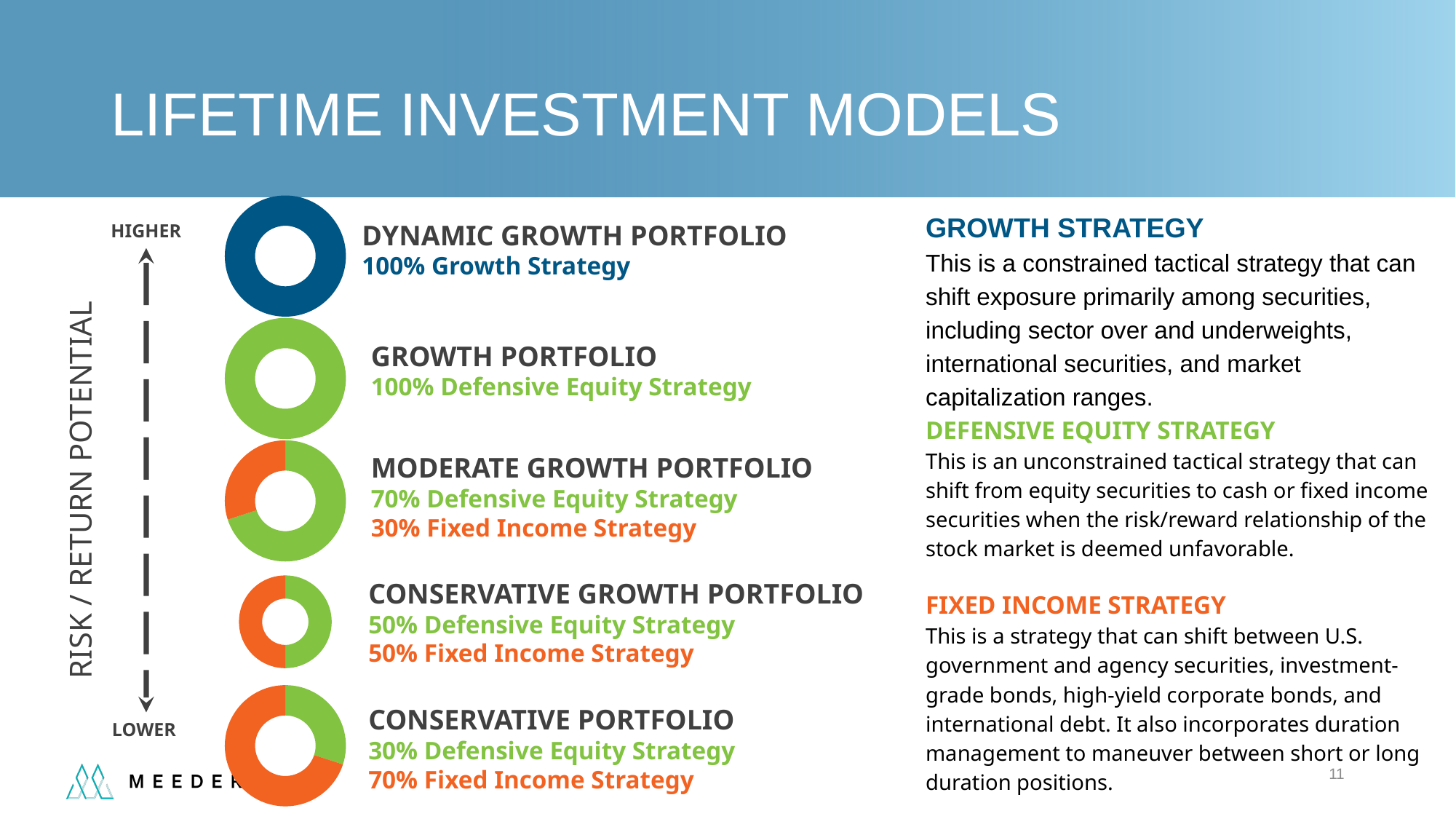
In the Conservative Portfolio chart, which slice is larger: Defensive Equity Strategy or Fixed Income Strategy? Fixed Income Strategy In the Dynamic Growth Portfolio chart, what share is allocated to the Growth Strategy? 100% Which portfolio chart has the largest Fixed Income Strategy share? Conservative Portfolio In the Moderate Growth Portfolio chart, what share is allocated to the Fixed Income Strategy? 30% In the Moderate Growth Portfolio chart, what share is allocated to the Defensive Equity Strategy? 70% What kind of chart is used to show each portfolio's allocation on the slide? Donut (pie) chart What colour represents the Fixed Income Strategy in the donut charts? Orange In the Moderate Growth Portfolio chart, what is the difference between the Defensive Equity Strategy share and the Fixed Income Strategy share? 40% How many donut charts are shown on the slide? 5